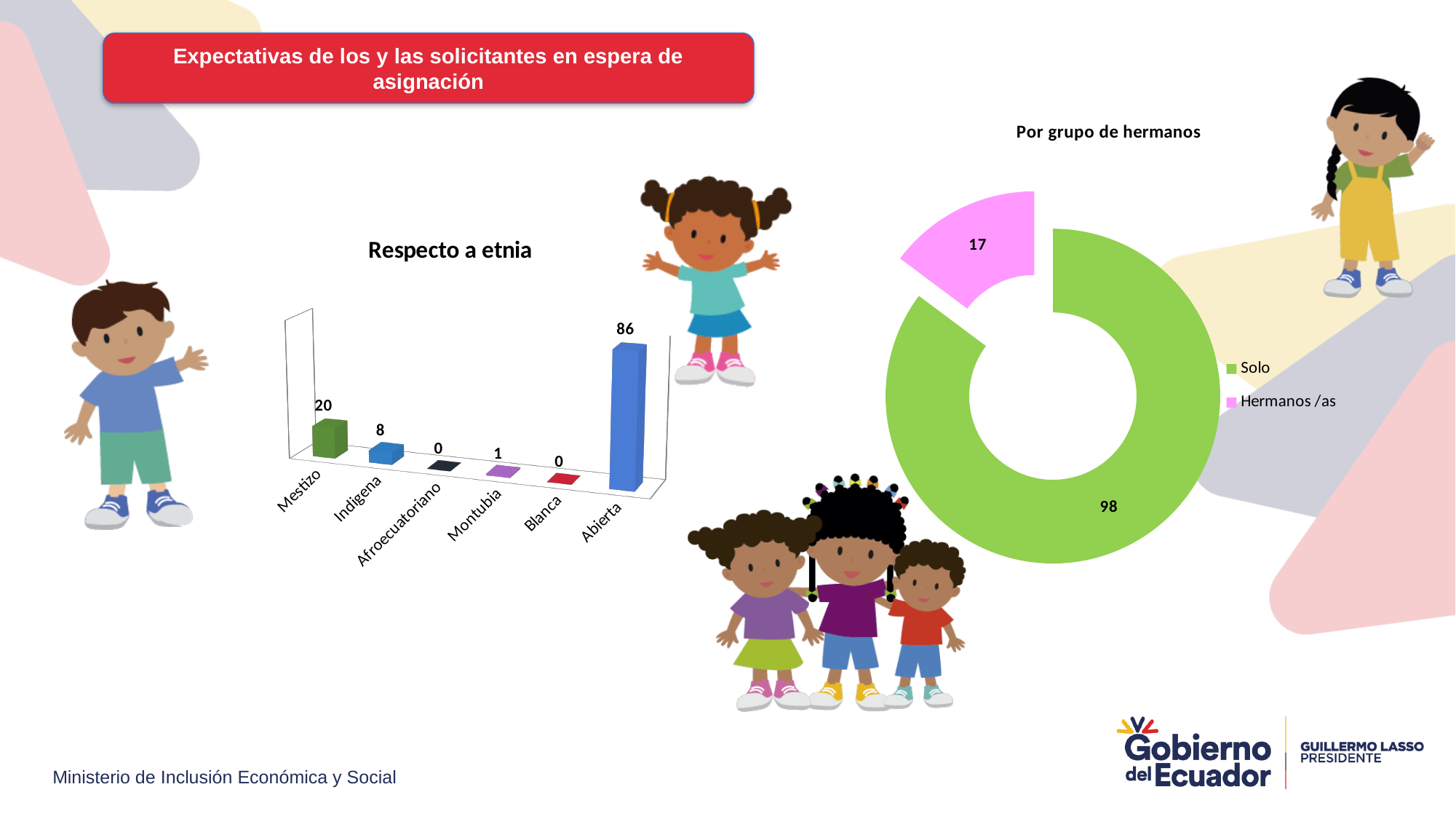
In the 'Respecto a etnia' chart, what is the value for Mestizo? 20 In the 'Respecto a etnia' chart, which is larger, Mestizo or Indigena? Mestizo In the 'Respecto a etnia' chart, which category has the highest value? Abierta In the 'Respecto a etnia' chart, how many categories are shown? 6 In the 'Por grupo de hermanos' chart, what is the value for Solo? 98 How many entries does the legend of the 'Por grupo de hermanos' chart list? 2 In the 'Respecto a etnia' chart, what is the difference between Abierta and Mestizo? 66 In the 'Respecto a etnia' chart, what is the value for Abierta? 86 In the 'Por grupo de hermanos' chart, what is the difference between Solo and Hermanos /as? 81 What kind of chart is 'Respecto a etnia'? Bar chart In the 'Respecto a etnia' chart, what is the value for Indigena? 8 In the 'Por grupo de hermanos' chart, what is the value for Hermanos /as? 17